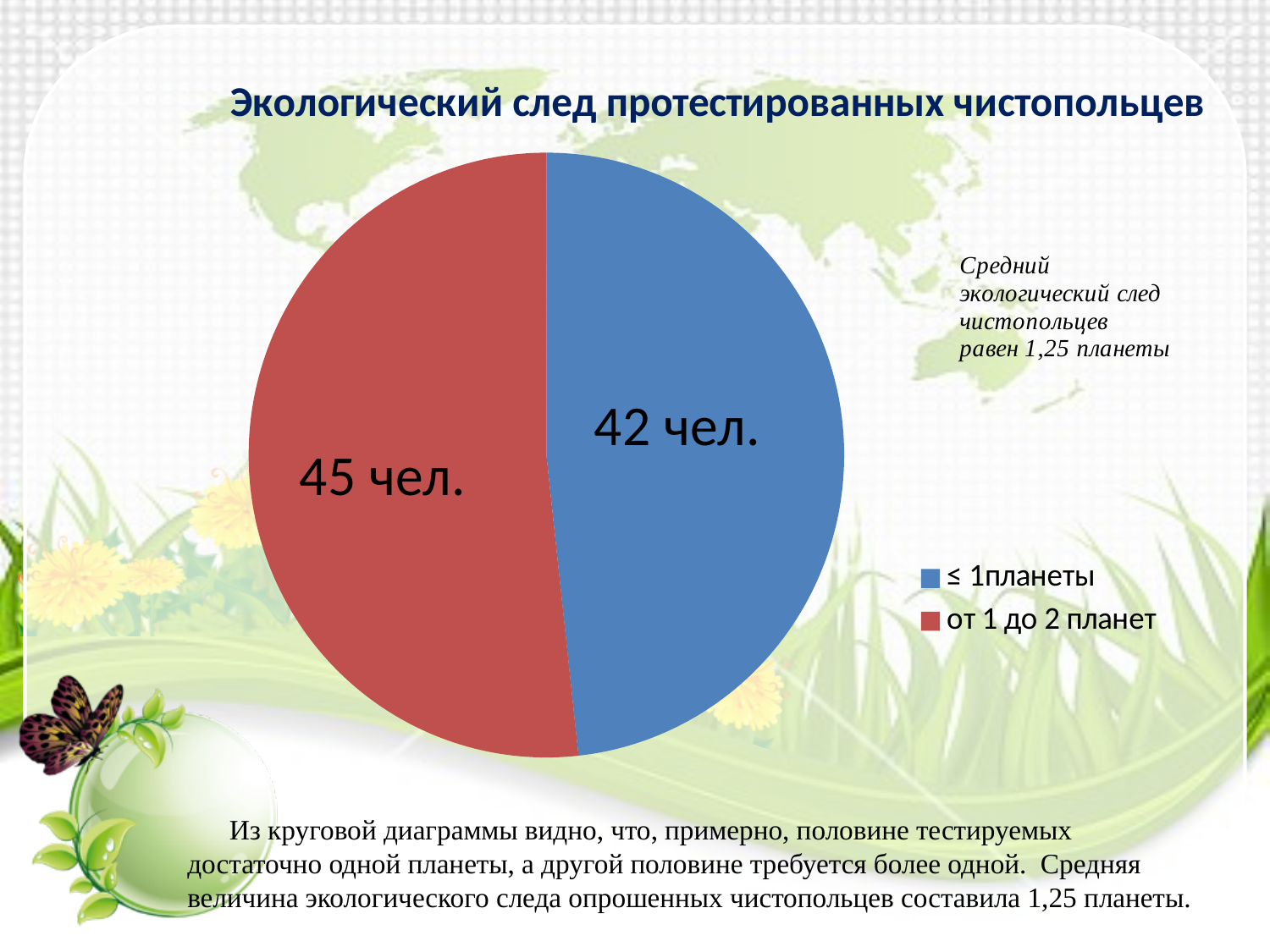
How many slices does the pie chart have? 2 What is the total number of people represented in the pie chart? 87 чел. What is the difference between the number of people in the "от 1 до 2 планет" slice and the "≤ 1планеты" slice? 3 чел. What is the title of the chart on the slide? Экологический след протестированных чистопольцев Is the value for "≤ 1планеты" larger or smaller than the value for "от 1 до 2 планет"? smaller Which category has the smaller slice in the pie chart? ≤ 1планеты How many entries does the legend of the pie chart list? 2 How many people are in the "от 1 до 2 планет" slice of the pie chart? 45 чел. What type of chart is shown on the slide? pie chart What colour is the "от 1 до 2 планет" slice in the pie chart? red Which category has the larger slice in the pie chart? от 1 до 2 планет How many people are in the "≤ 1планеты" slice of the pie chart? 42 чел.